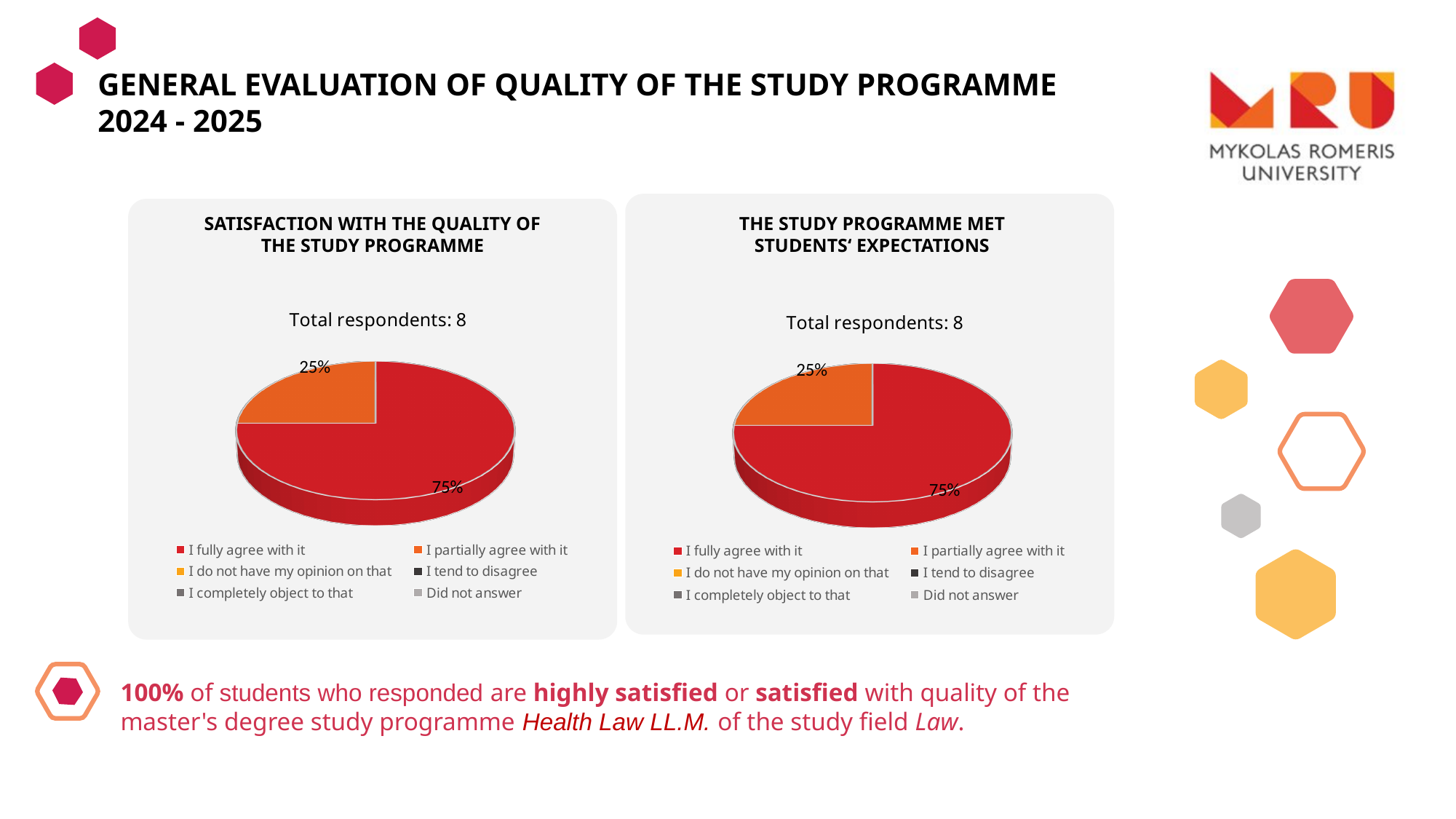
In the 'The study programme met students' expectations' chart, which is larger: 'I fully agree with it' or 'I partially agree with it'? I fully agree with it In the 'The study programme met students' expectations' chart, which response has the largest share? I fully agree with it How many total respondents are reported for the 'Satisfaction with the quality of the study programme' chart? 8 How many entries does the legend of the 'The study programme met students' expectations' chart list? 6 In the 'Satisfaction with the quality of the study programme' chart, what share of respondents chose 'I partially agree with it'? 25% What type of chart is used in the 'Satisfaction with the quality of the study programme' panel? Pie chart In the 'Satisfaction with the quality of the study programme' chart, what colour represents 'I partially agree with it'? Orange In the 'Satisfaction with the quality of the study programme' chart, what is the difference between the 'I fully agree with it' and 'I partially agree with it' shares? 50% In the 'The study programme met students' expectations' chart, what share of respondents chose 'I partially agree with it'? 25% In the 'Satisfaction with the quality of the study programme' chart, which response has the largest share? I fully agree with it In the 'Satisfaction with the quality of the study programme' chart, what share of respondents chose 'I fully agree with it'? 75% In the 'The study programme met students' expectations' chart, what share of respondents chose 'I fully agree with it'? 75%